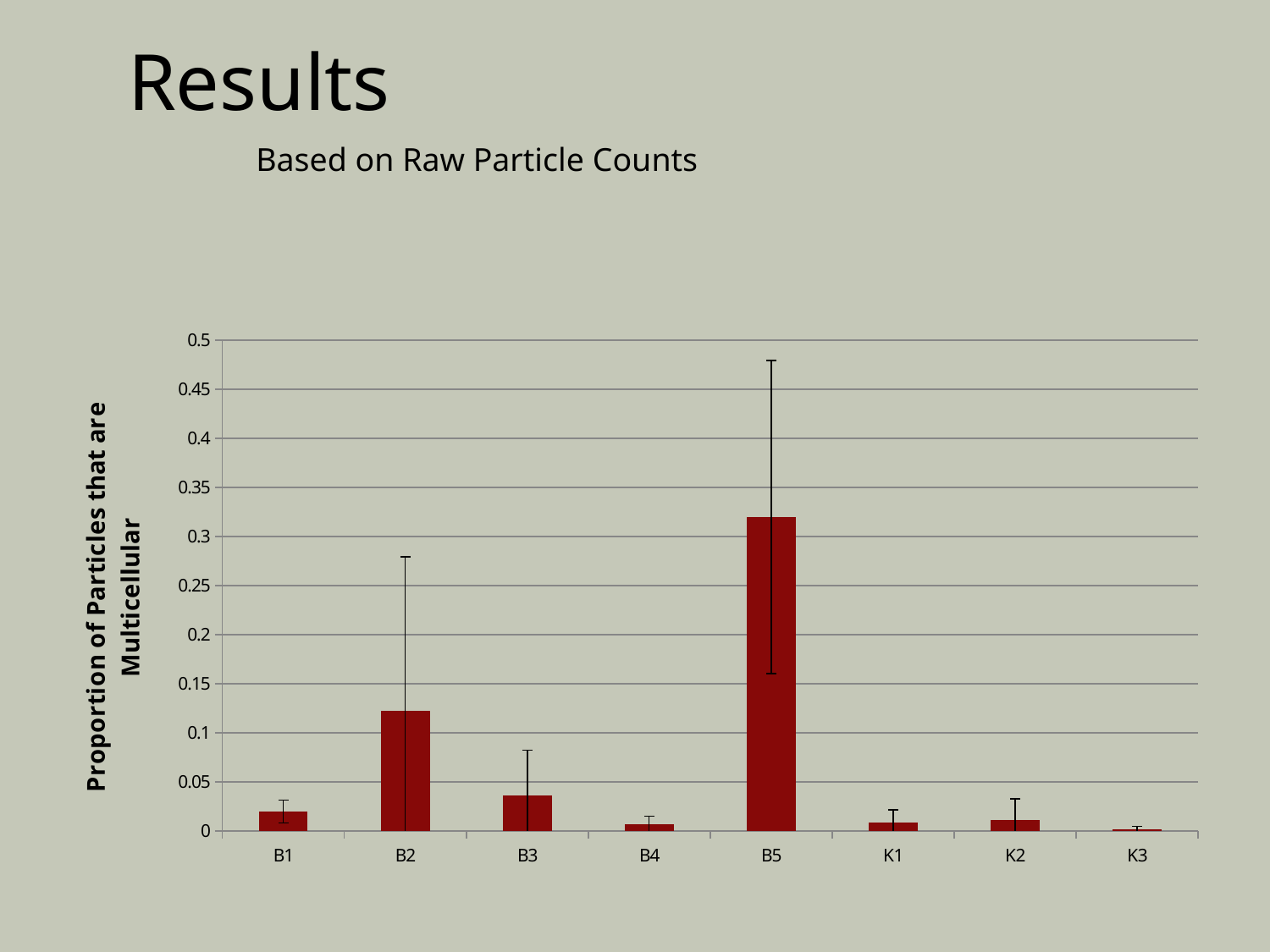
Is the value for B1 greater or less than 0.05? less Is the value for B5 greater or less than 0.3? greater Is the value for B5 greater or less than 0.35? less Which has a larger value, B2 or B3? B2 Which has a larger value, B1 or B4? B1 What kind of chart is shown on the slide? bar chart How many categories are shown on the x axis of the chart? 8 Which category has the lowest proportion of particles that are multicellular? K3 What is the title of the y axis of the chart? Proportion of Particles that are Multicellular Which category has the highest proportion of particles that are multicellular? B5